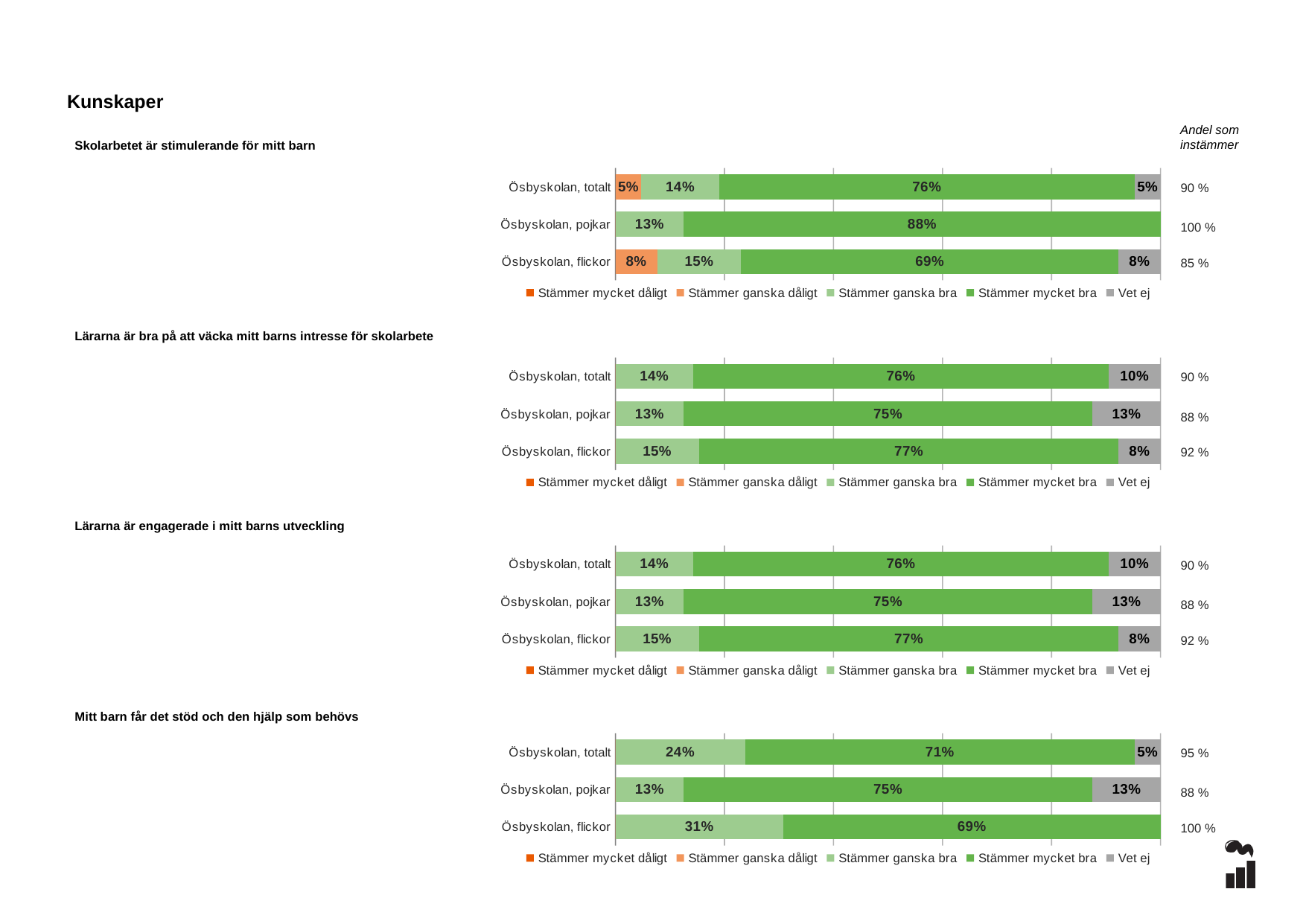
In the chart 'Skolarbetet är stimulerande för mitt barn', what is the 'Stämmer ganska dåligt' value for Ösbyskolan, flickor? 8% How many categories are shown in the chart 'Skolarbetet är stimulerande för mitt barn'? 3 In the chart 'Mitt barn får det stöd och den hjälp som behövs', what is the 'Stämmer ganska bra' value for Ösbyskolan, flickor? 31% What kind of chart is 'Mitt barn får det stöd och den hjälp som behövs'? Stacked bar chart In the chart 'Lärarna är bra på att väcka mitt barns intresse för skolarbete', what is the difference between the 'Stämmer mycket bra' values for Ösbyskolan, flickor and Ösbyskolan, pojkar? 2% How many series does the legend of the chart 'Lärarna är engagerade i mitt barns utveckling' list? 5 In the chart 'Lärarna är bra på att väcka mitt barns intresse för skolarbete', what is the 'Vet ej' value for Ösbyskolan, pojkar? 13% In the chart 'Skolarbetet är stimulerande för mitt barn', which category has the highest 'Stämmer mycket bra' value? Ösbyskolan, pojkar In the chart 'Mitt barn får det stöd och den hjälp som behövs', is the 'Stämmer ganska bra' value larger for Ösbyskolan, totalt or Ösbyskolan, pojkar? Ösbyskolan, totalt In the chart 'Skolarbetet är stimulerande för mitt barn', what is the 'Stämmer mycket bra' value for Ösbyskolan, pojkar? 88% In the chart 'Mitt barn får det stöd och den hjälp som behövs', what is the difference between the 'Stämmer mycket bra' values for Ösbyskolan, pojkar and Ösbyskolan, totalt? 4% In the chart 'Lärarna är engagerade i mitt barns utveckling', which category has the lowest 'Vet ej' value? Ösbyskolan, flickor